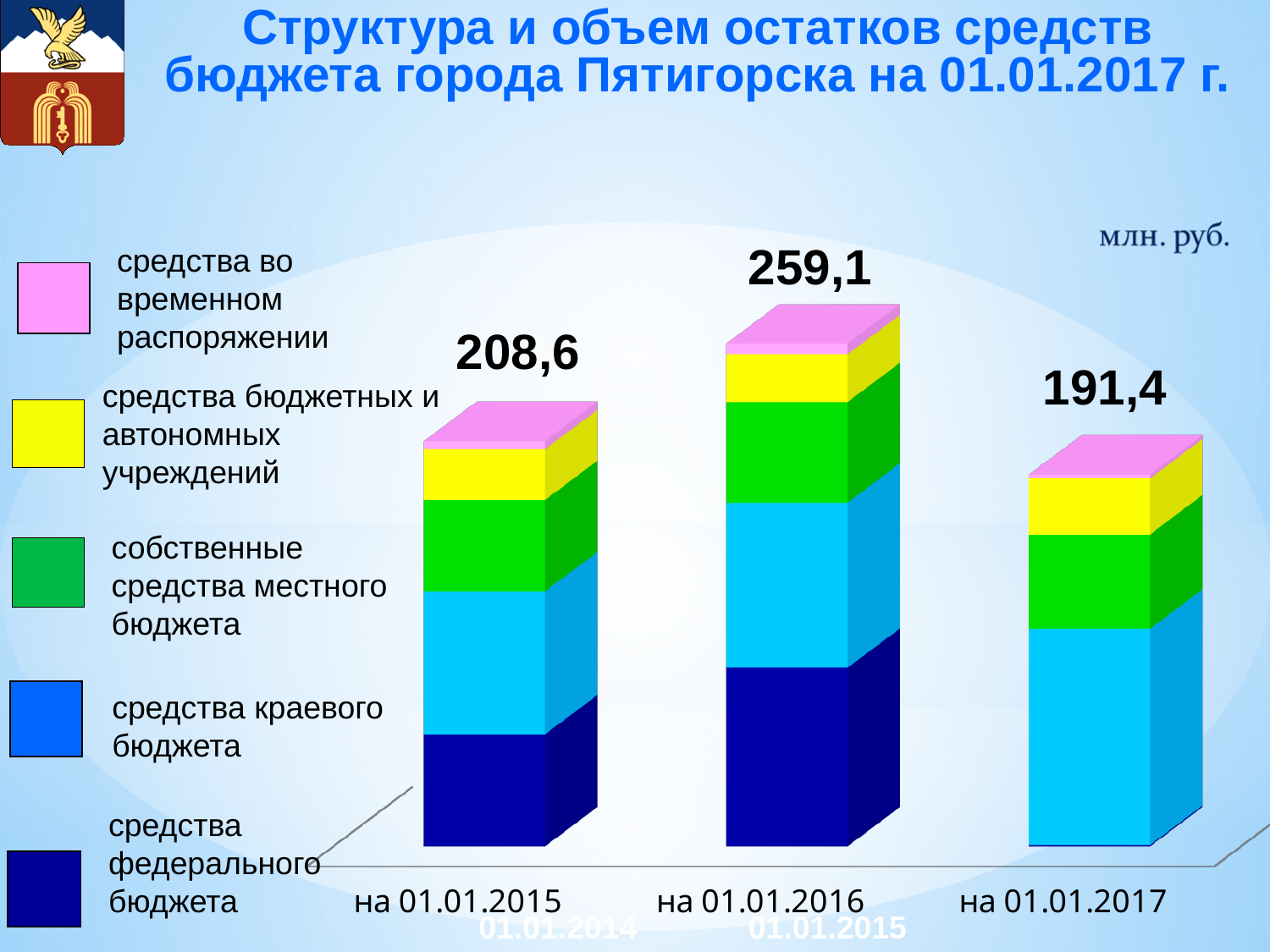
What is the total value shown for the bar labelled на 01.01.2016? 259,1 Which legend entry is shown in dark blue? средства федерального бюджета What is the total value shown for the bar labelled на 01.01.2017? 191,4 What is the difference between the totals for на 01.01.2015 and на 01.01.2017? 17,2 Which date has the lowest total value? на 01.01.2017 How many series does the legend list? 5 What is the difference between the totals for на 01.01.2016 and на 01.01.2015? 50,5 Which date has the highest total value? на 01.01.2016 Which is larger, the total for на 01.01.2015 or the total for на 01.01.2017? на 01.01.2015 What is the total value shown for the bar labelled на 01.01.2015? 208,6 How many bars (dates) are shown in the chart? 3 What kind of chart is shown on the slide? Stacked bar chart